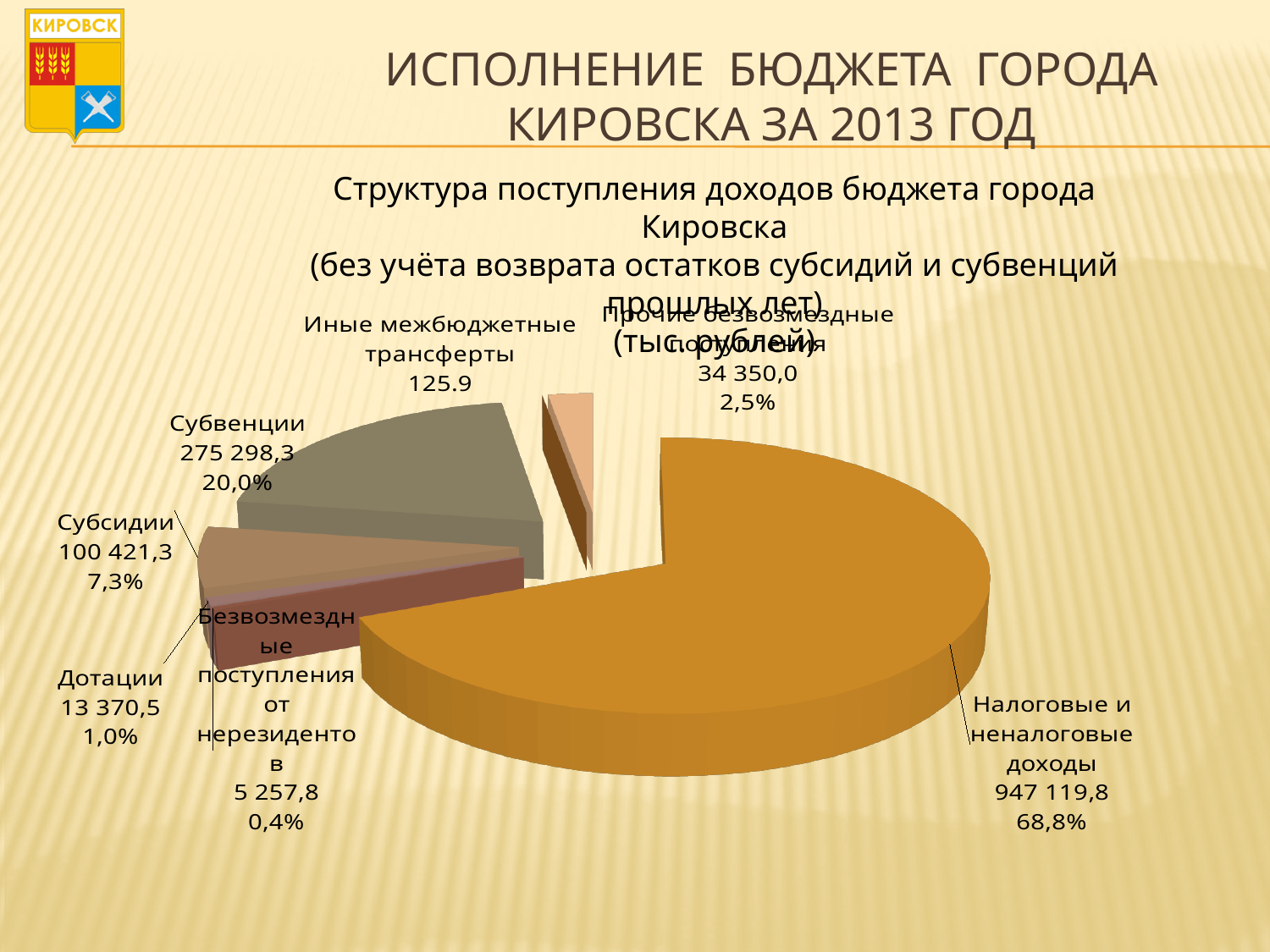
What kind of chart is shown on the slide? pie chart Which category has the largest slice of the pie? Налоговые и неналоговые доходы What is the value for Дотации? 13 370,5 What is the difference between the values for Субвенции and Субсидии? 174 877,0 Which is larger: Дотации or Безвозмездные поступления от нерезидентов? Дотации What share of the pie does Субвенции represent? 20,0% Which category has the smallest value? Иные межбюджетные трансферты What is the value for Налоговые и неналоговые доходы? 947 119,8 What share of the pie does Прочие безвозмездные поступления represent? 2,5% How many categories are shown in the pie chart? 7 What is the value for Субсидии? 100 421,3 What is the value for Субвенции? 275 298,3